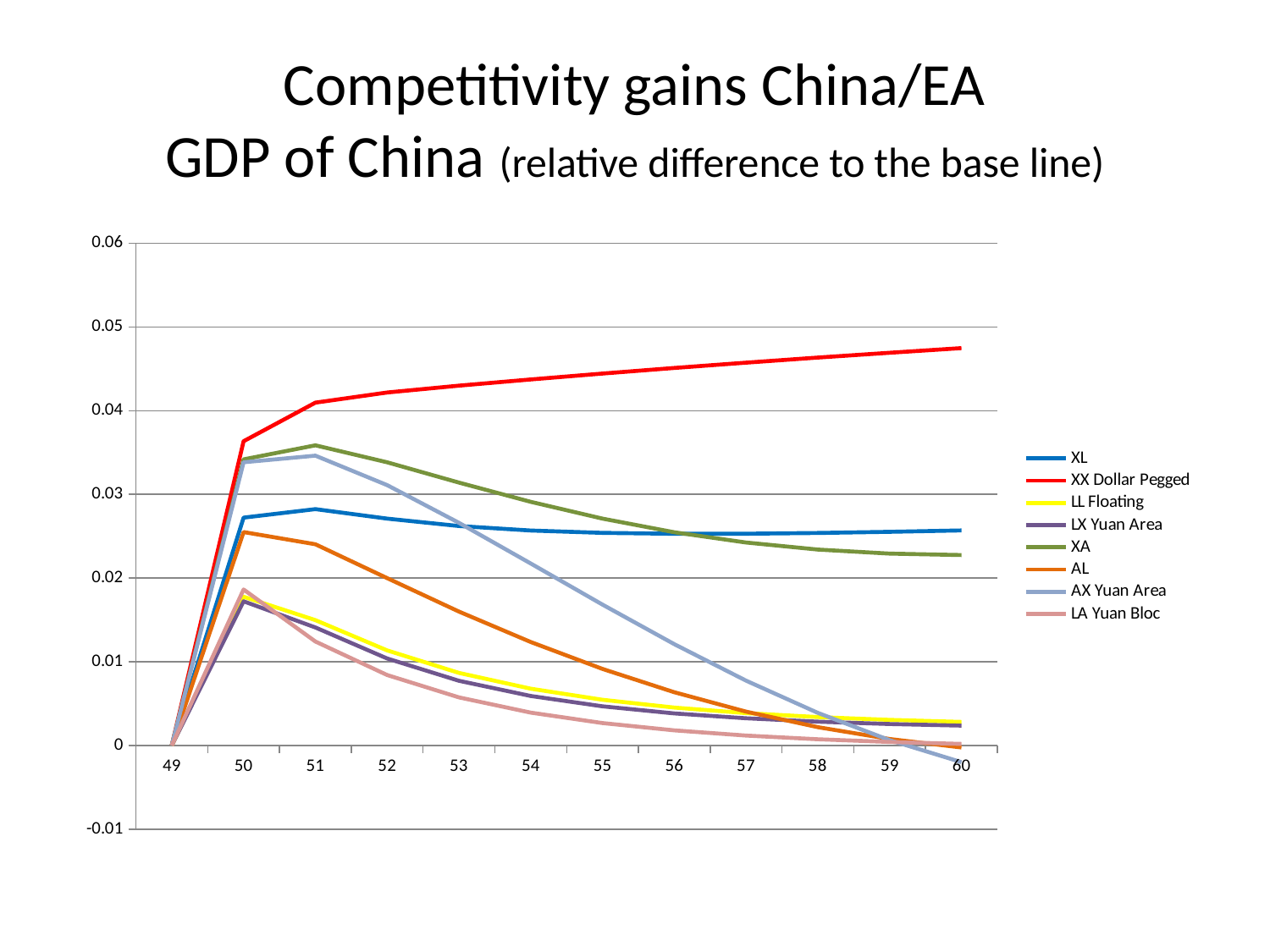
What kind of chart is shown on the slide? line chart Which series is drawn in red in the legend? XX Dollar Pegged Is the value for AL at x = 60 greater or less than 0.01? less Is the value for XX Dollar Pegged at x = 60 greater or less than 0.04? greater Does the AX Yuan Area series rise or fall from x = 51 to x = 60? fall Which series has the highest value at x = 60? XX Dollar Pegged How many series does the legend list? 8 Is the value for XA at x = 60 greater or less than 0.03? less How many points are labelled along the x axis? 12 Which series has the lowest value at x = 60? AX Yuan Area Does the XX Dollar Pegged series rise or fall from x = 51 to x = 60? rise At x = 60, which is larger: XL or XA? XL